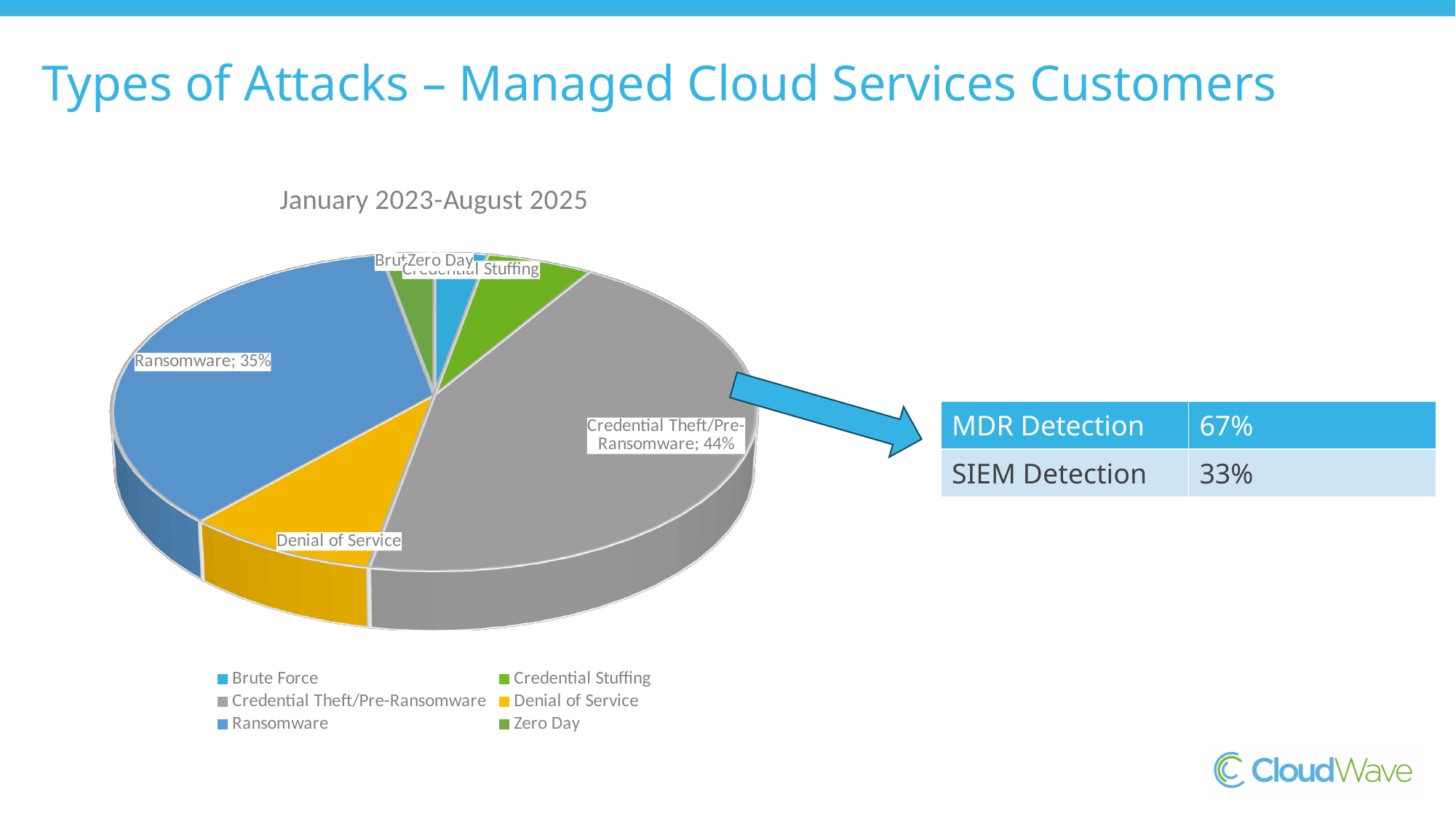
By how many percentage points does Credential Theft/Pre-Ransomware exceed Ransomware? 9 percentage points What is the title shown above the pie chart? January 2023-August 2025 How many attack types are shown in the pie chart? 6 What share of attacks is Ransomware? 35% What share of attacks is Credential Theft/Pre-Ransomware? 44% How many entries does the legend list? 6 Which is larger, the Credential Stuffing slice or the Denial of Service slice? Denial of Service What kind of chart is shown on the slide? pie chart Which is larger, the Credential Theft/Pre-Ransomware slice or the Ransomware slice? Credential Theft/Pre-Ransomware What is the combined share of Credential Theft/Pre-Ransomware and Ransomware? 79% Which is larger, the Denial of Service slice or the Ransomware slice? Ransomware Which attack type has the largest slice of the pie? Credential Theft/Pre-Ransomware